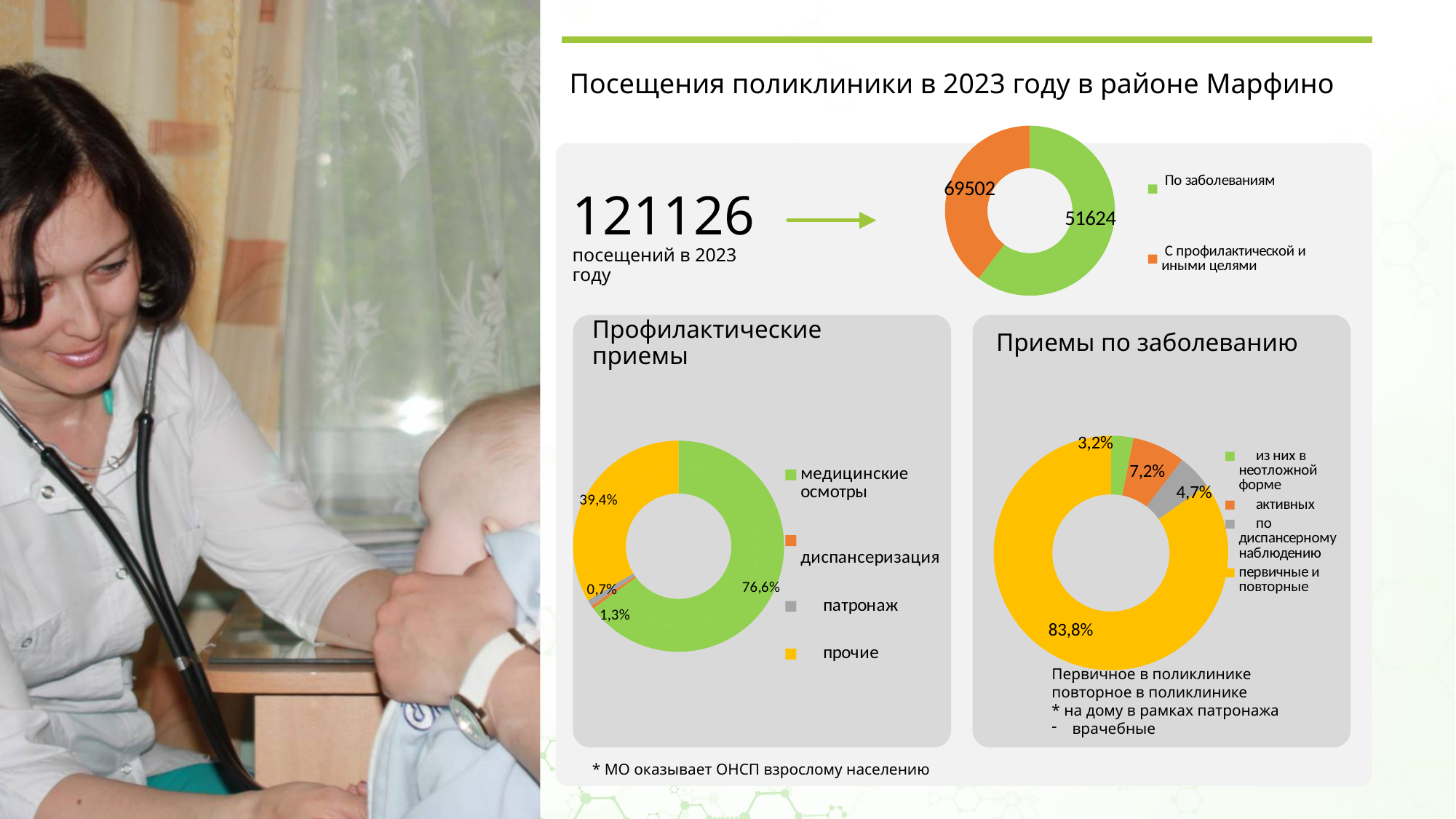
What kind of chart is used for 'Приемы по заболеванию'? Donut (pie) chart On the top donut chart, how many visits are labelled for 'С профилактической и иными целями'? 69502 On the 'Приемы по заболеванию' chart, what share is labelled for 'первичные и повторные'? 83,8% On the 'Профилактические приемы' chart, which category has the largest share? медицинские осмотры On the 'Приемы по заболеванию' chart, how many categories does the legend list? 4 On the top donut chart, what is the difference between the two labelled values, 69502 and 51624? 17878 On the 'Профилактические приемы' chart, what share is labelled for 'прочие'? 39,4% How many entries does the legend of the top donut chart list? 2 On the top donut chart, how many visits are labelled for 'По заболеваниям'? 51624 On the 'Приемы по заболеванию' chart, which category has the smallest share? из них в неотложной форме What total number of visits in 2023 is shown next to the top donut chart? 121126 On the 'Профилактические приемы' chart, what share is labelled for 'медицинские осмотры'? 76,6%